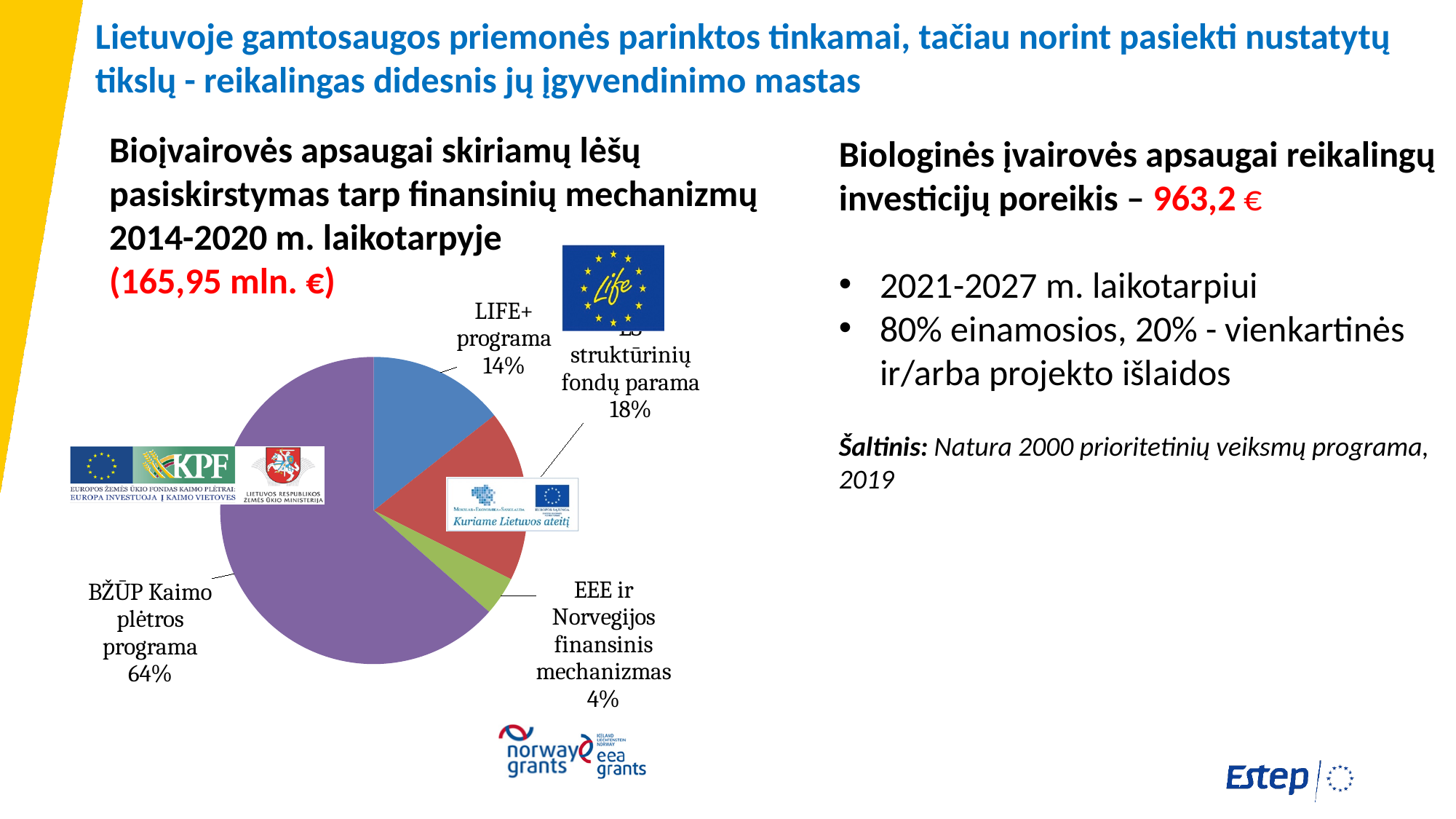
Which is larger, the share for LIFE+ programa or the share for struktūrinių fondų parama? struktūrinių fondų parama How many slices does the pie chart have? 4 What share of the pie does the struktūrinių fondų parama slice hold? 18% What share of the pie does EEE ir Norvegijos finansinis mechanizmas hold? 4% What is the difference in percentage points between BŽŪP Kaimo plėtros programa and LIFE+ programa? 50 What total amount in mln. € is stated in the pie chart's title for the 2014-2020 period? 165,95 mln. € What share of the pie does LIFE+ programa hold? 14% Which slice of the pie chart is the largest? BŽŪP Kaimo plėtros programa Which slice of the pie chart is the smallest? EEE ir Norvegijos finansinis mechanizmas What kind of chart is shown on the slide? pie chart What colour is the BŽŪP Kaimo plėtros programa slice in the pie chart? purple